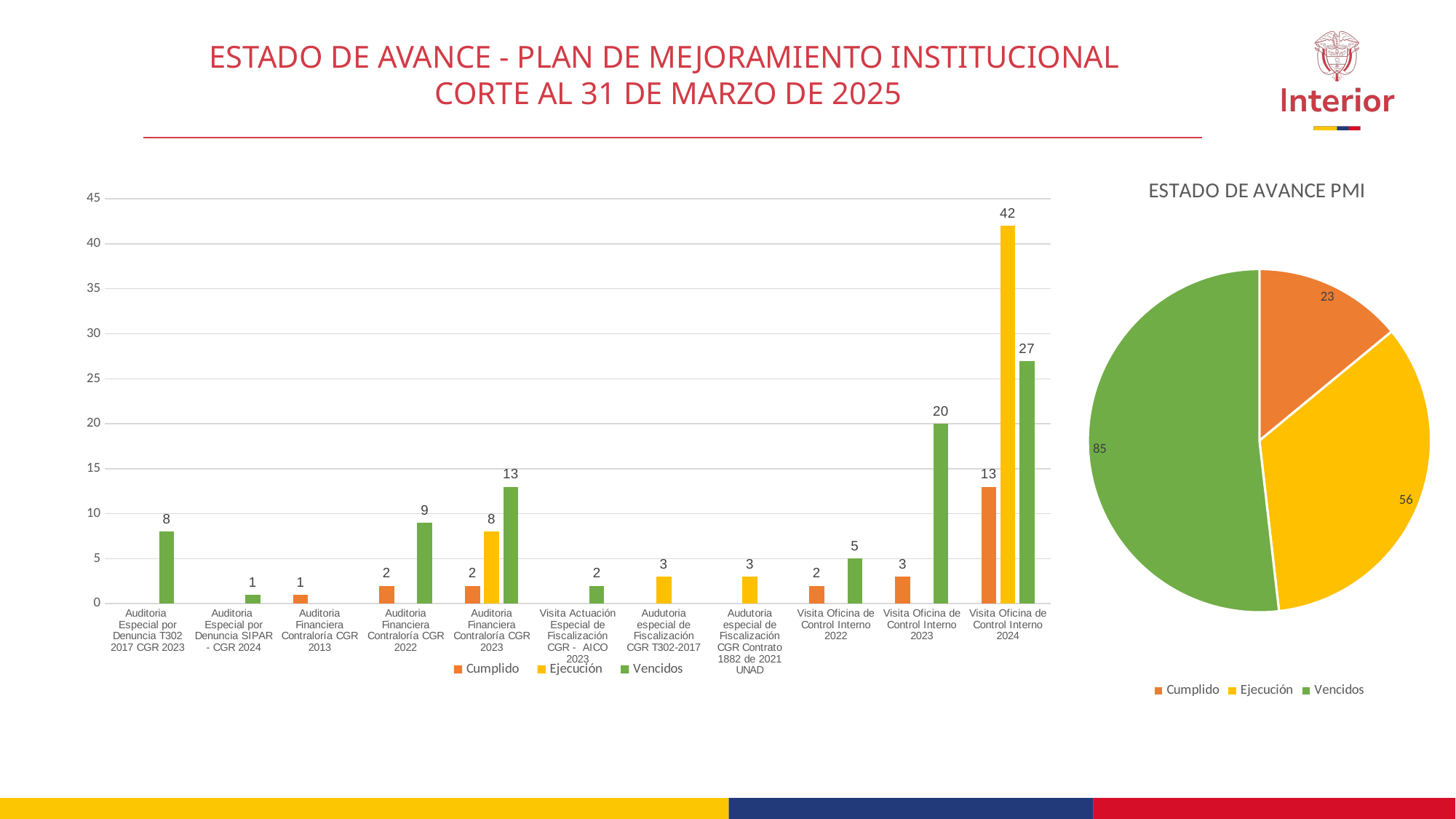
In the pie chart ESTADO DE AVANCE PMI, what is the difference between the Ejecución and Cumplido values? 33 How many series does the legend of the left bar chart list? 3 On the left bar chart, which is larger: the Vencidos value for Auditoria Financiera Contraloría CGR 2022 or for Visita Oficina de Control Interno 2022? Auditoria Financiera Contraloría CGR 2022 What kind of chart is the chart titled ESTADO DE AVANCE PMI? Pie chart On the left bar chart, what is the Vencidos value for Visita Oficina de Control Interno 2023? 20 In the pie chart ESTADO DE AVANCE PMI, what is the value for Vencidos? 85 On the left bar chart, which category has the highest Vencidos value? Visita Oficina de Control Interno 2024 On the left bar chart, what is the Ejecución value for Visita Oficina de Control Interno 2024? 42 On the left bar chart, what is the Vencidos value for Auditoria Financiera Contraloría CGR 2023? 13 In the pie chart ESTADO DE AVANCE PMI, which slice is the smallest? Cumplido How many categories are shown on the x axis of the left bar chart? 11 On the left bar chart, what is the difference between the Ejecución and Vencidos values for Visita Oficina de Control Interno 2024? 15